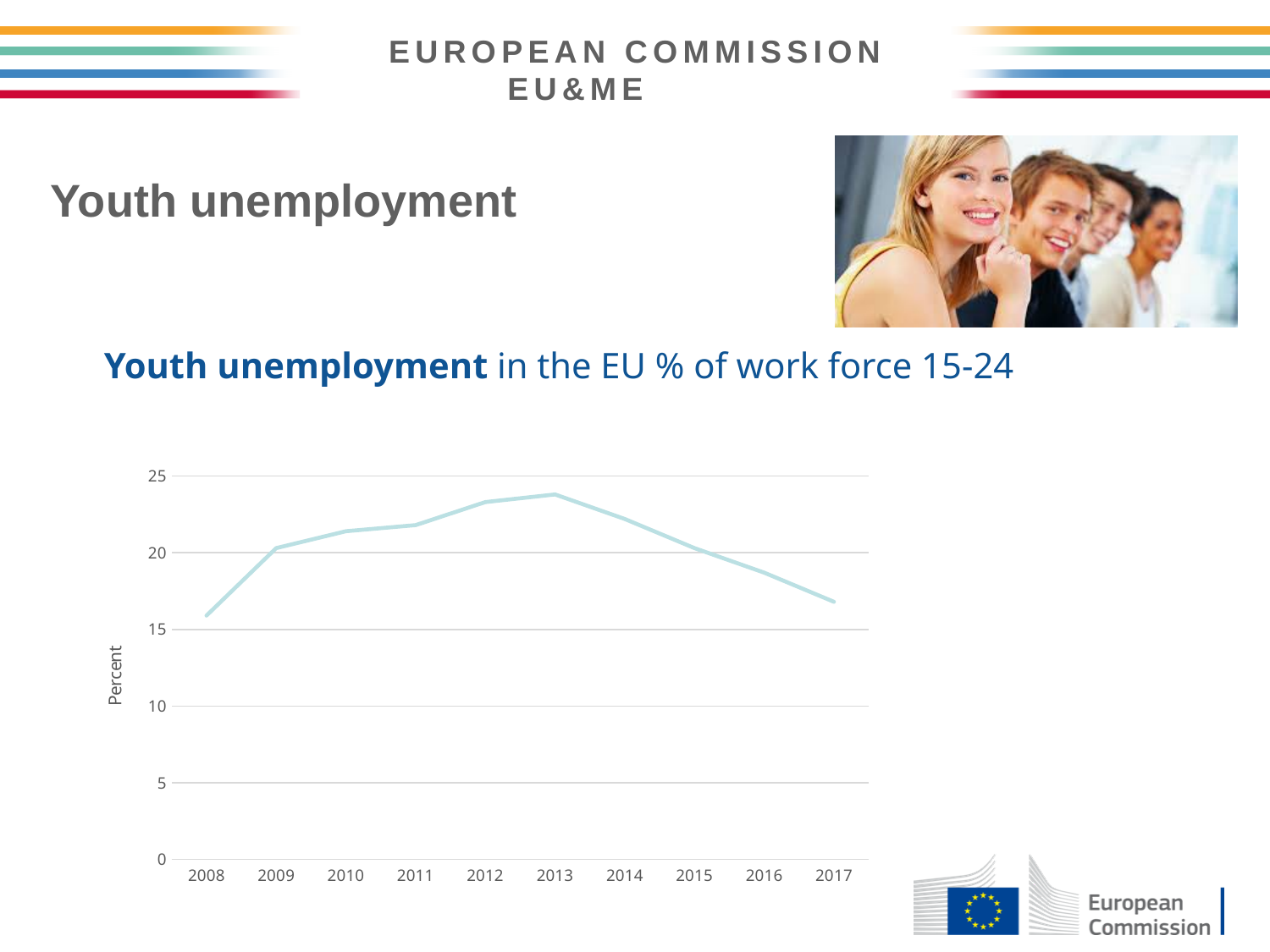
What kind of chart is shown on the slide? line chart Is the value for 2008 greater or less than 15? greater Is the value for 2012 greater or less than 25? less Is the value for 2016 greater or less than 20? less Does the youth unemployment line rise or fall between 2008 and 2013? rise Which year has the higher youth unemployment value, 2013 or 2017? 2013 In which year does the youth unemployment line reach its highest point? 2013 What is the label on the vertical axis of the chart? Percent How many years are plotted along the x axis of the chart? 10 Does the youth unemployment line rise or fall between 2013 and 2017? fall